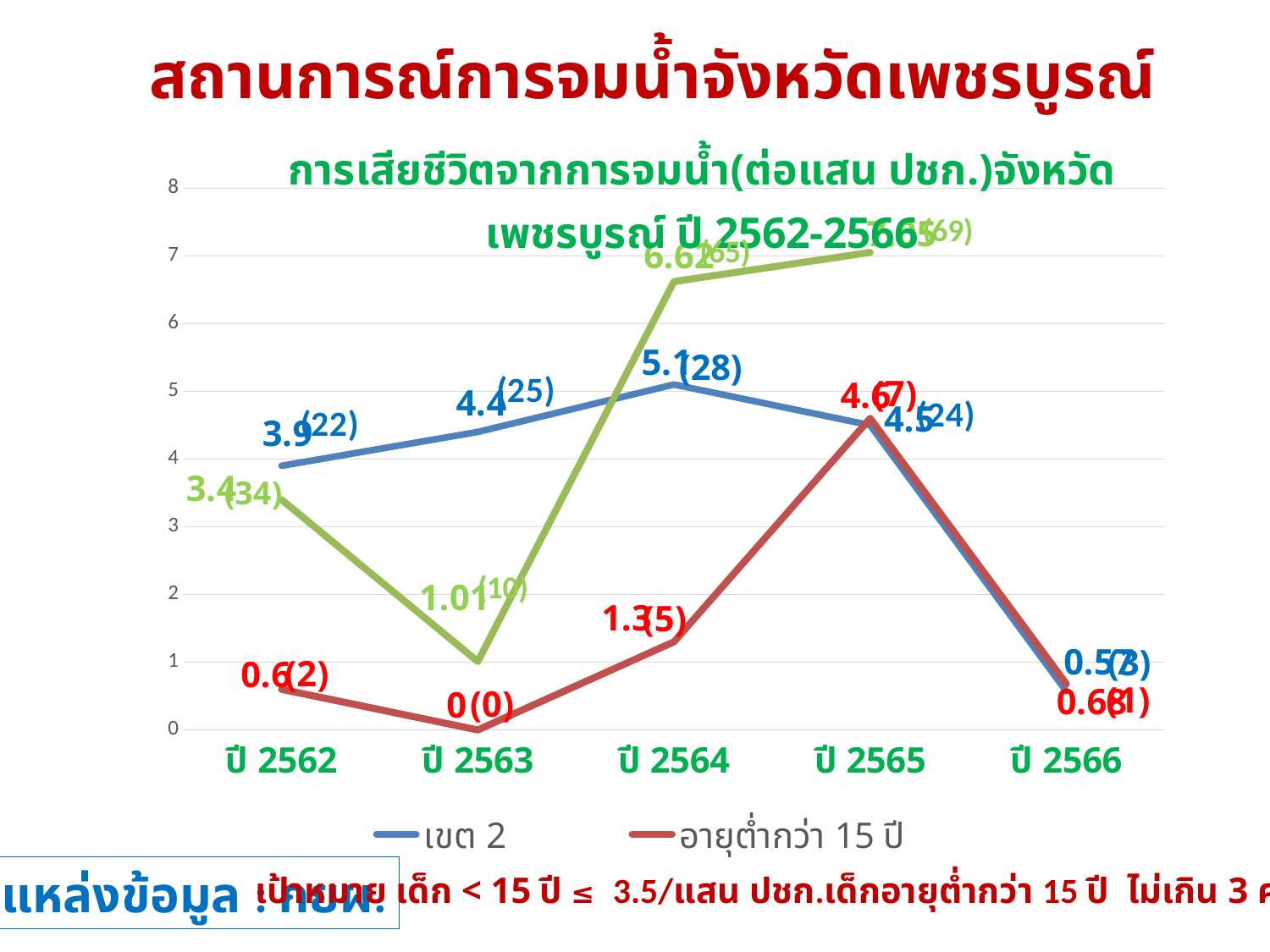
In ปี 2562, which is larger: the value for เขต 2 or the value for อายุต่ำกว่า 15 ปี? เขต 2 In which year is the value for อายุต่ำกว่า 15 ปี highest? ปี 2565 What is the value for อายุต่ำกว่า 15 ปี in ปี 2563? 0 What is the value for อายุต่ำกว่า 15 ปี in ปี 2564? 1.3 What is the difference between the เขต 2 values for ปี 2564 and ปี 2563? 0.7 How many years (categories) are shown on the x axis? 5 In which year is the value for เขต 2 highest? ปี 2564 What is the value for เขต 2 in ปี 2564? 5.1 Which colour is used for the อายุต่ำกว่า 15 ปี series? red In which year is the value for เขต 2 lowest? ปี 2566 What kind of chart is shown on the slide? line chart Is the value of the green line in ปี 2564 greater or less than 6? greater